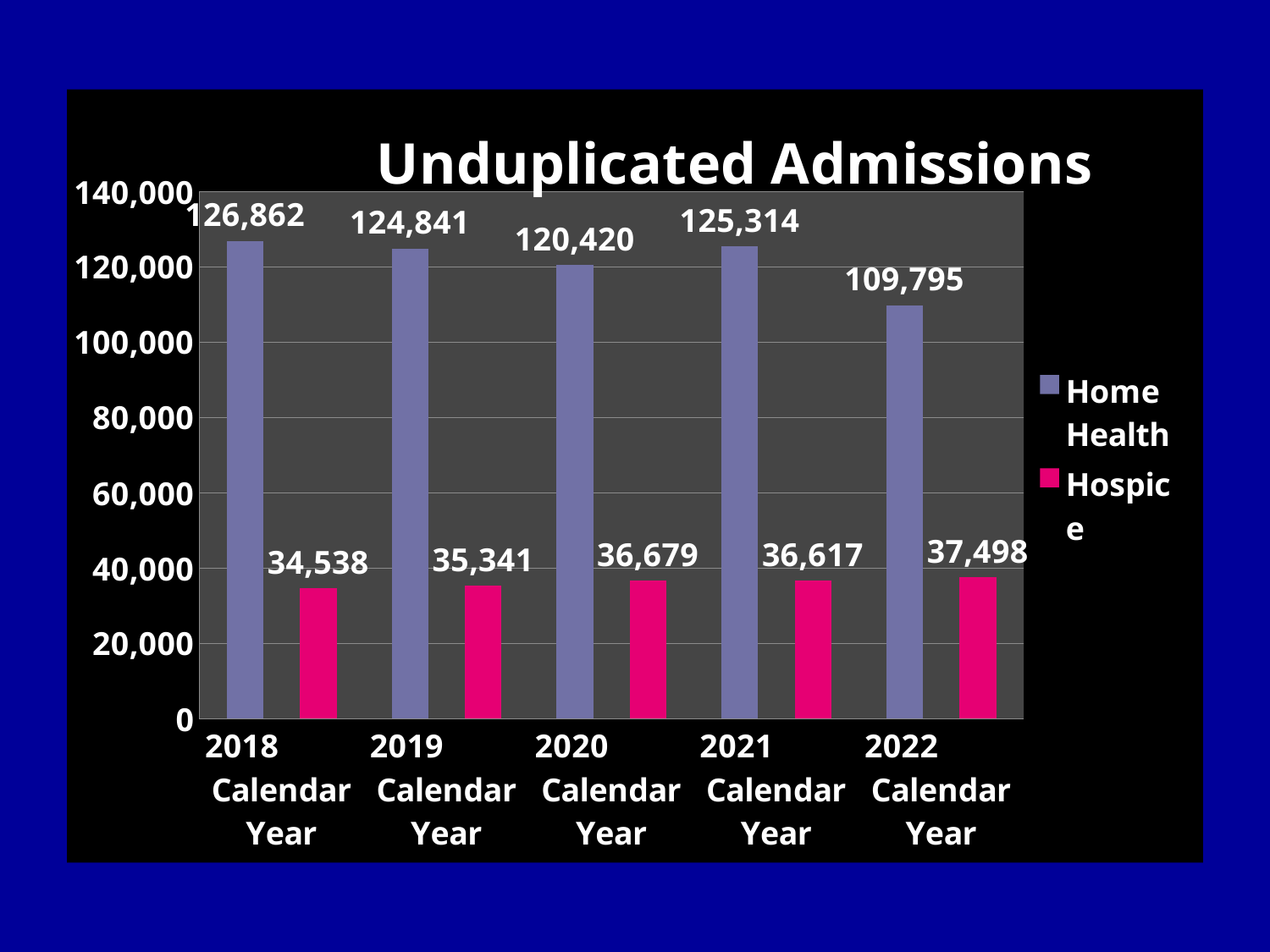
Is the Home Health value for 2022 Calendar Year greater or less than 120,000? less Which calendar year has the lowest Home Health value? 2022 Calendar Year Which is larger, the Home Health value for 2019 Calendar Year or for 2021 Calendar Year? 2021 Calendar Year What is the Home Health value for 2018 Calendar Year? 126,862 What is the difference between the Hospice values for 2019 Calendar Year and 2018 Calendar Year? 803 What is the title of the chart? Unduplicated Admissions What is the Home Health value for 2020 Calendar Year? 120,420 How many series does the legend list? 2 How many calendar years are shown on the x axis? 5 Which calendar year has the highest Hospice value? 2022 Calendar Year What is the Hospice value for 2022 Calendar Year? 37,498 What is the difference between the Home Health values for 2018 Calendar Year and 2022 Calendar Year? 17,067